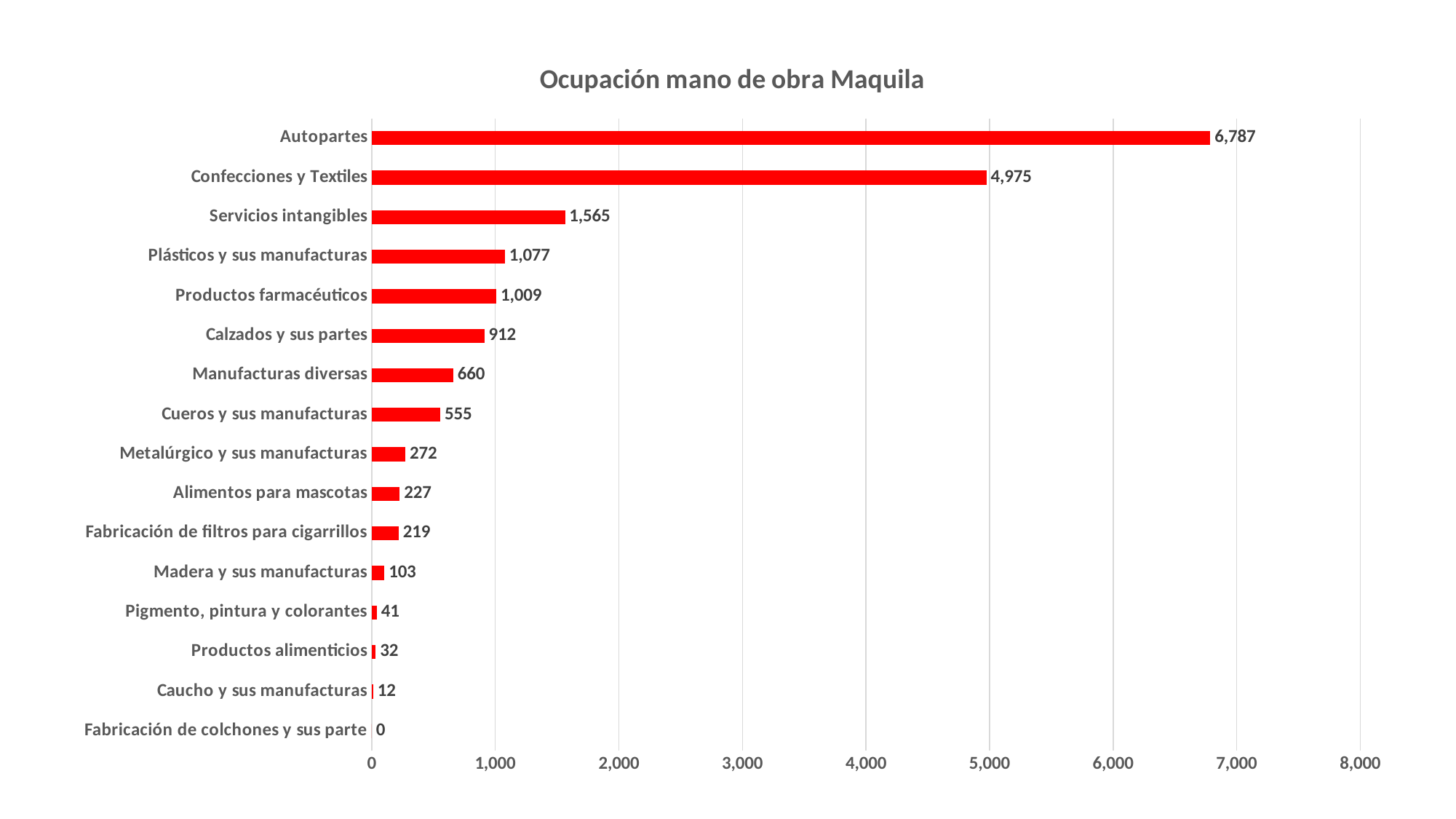
What is the value for Fabricación de filtros para cigarrillos? 219 Is the value for Confecciones y Textiles greater or less than 4,000? greater Which category has the highest value? Autopartes What is the value for Calzados y sus partes? 912 What is the difference between Autopartes and Confecciones y Textiles? 1,812 What is the value for Autopartes? 6,787 What is the title of the chart? Ocupación mano de obra Maquila What is the value for Servicios intangibles? 1,565 How many categories are shown in the chart? 16 Which is larger, Plásticos y sus manufacturas or Productos farmacéuticos? Plásticos y sus manufacturas Which category has the lowest value? Fabricación de colchones y sus parte What kind of chart is this? Bar chart